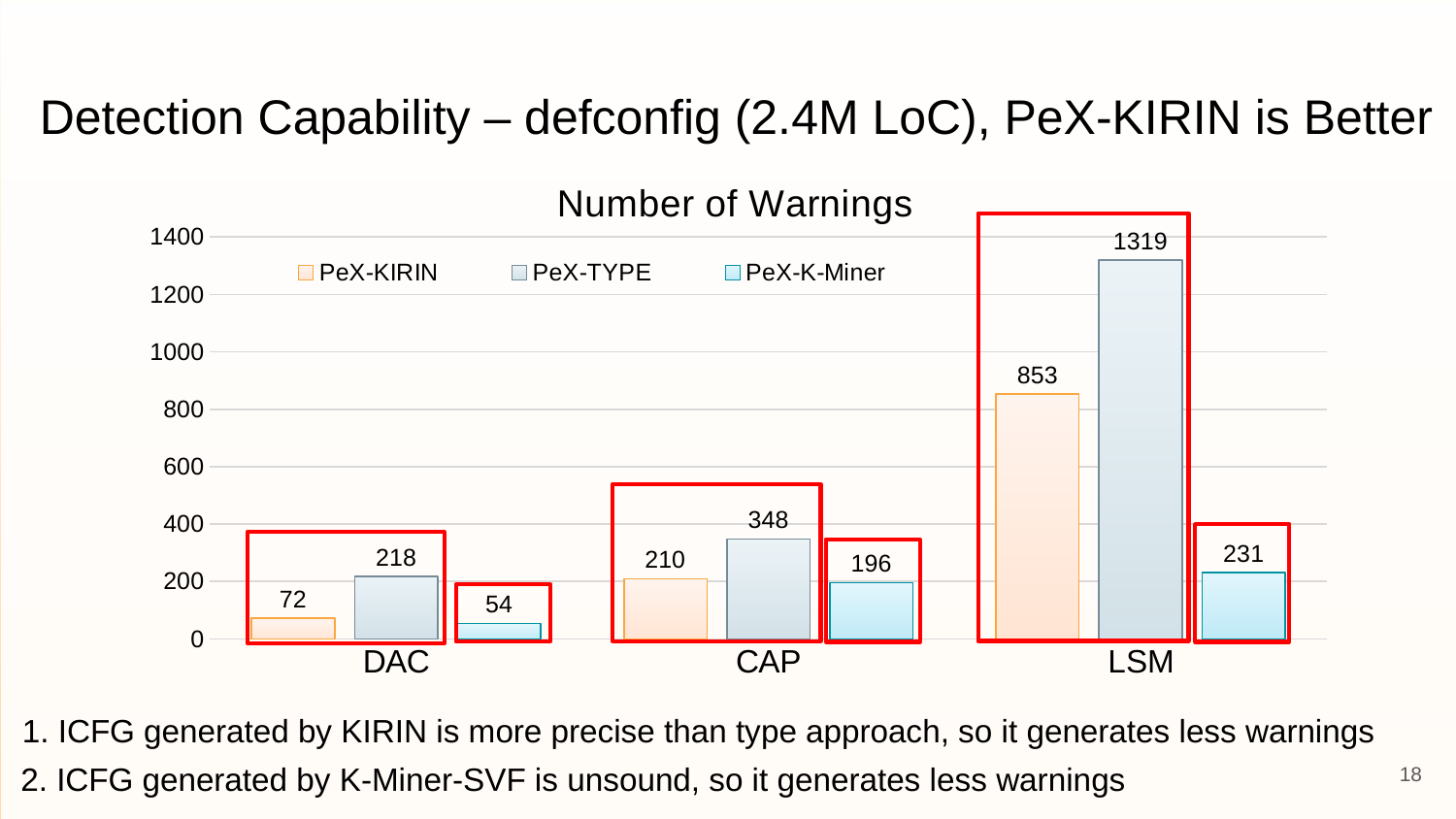
How many categories are shown on the x axis? 3 Which category has the highest number of warnings for PeX-KIRIN? LSM What is the number of warnings for PeX-KIRIN on DAC? 72 Which has more warnings on CAP, PeX-KIRIN or PeX-K-Miner? PeX-KIRIN How many series does the legend list? 3 What is the number of warnings for PeX-TYPE on LSM? 1319 Is the value for PeX-TYPE on CAP greater or less than 400? less What is the difference between PeX-TYPE and PeX-KIRIN warnings on LSM? 466 What is the number of warnings for PeX-K-Miner on CAP? 196 Which category has the lowest number of warnings for PeX-K-Miner? DAC What is the title of the chart? Number of Warnings What kind of chart is shown on the slide? bar chart